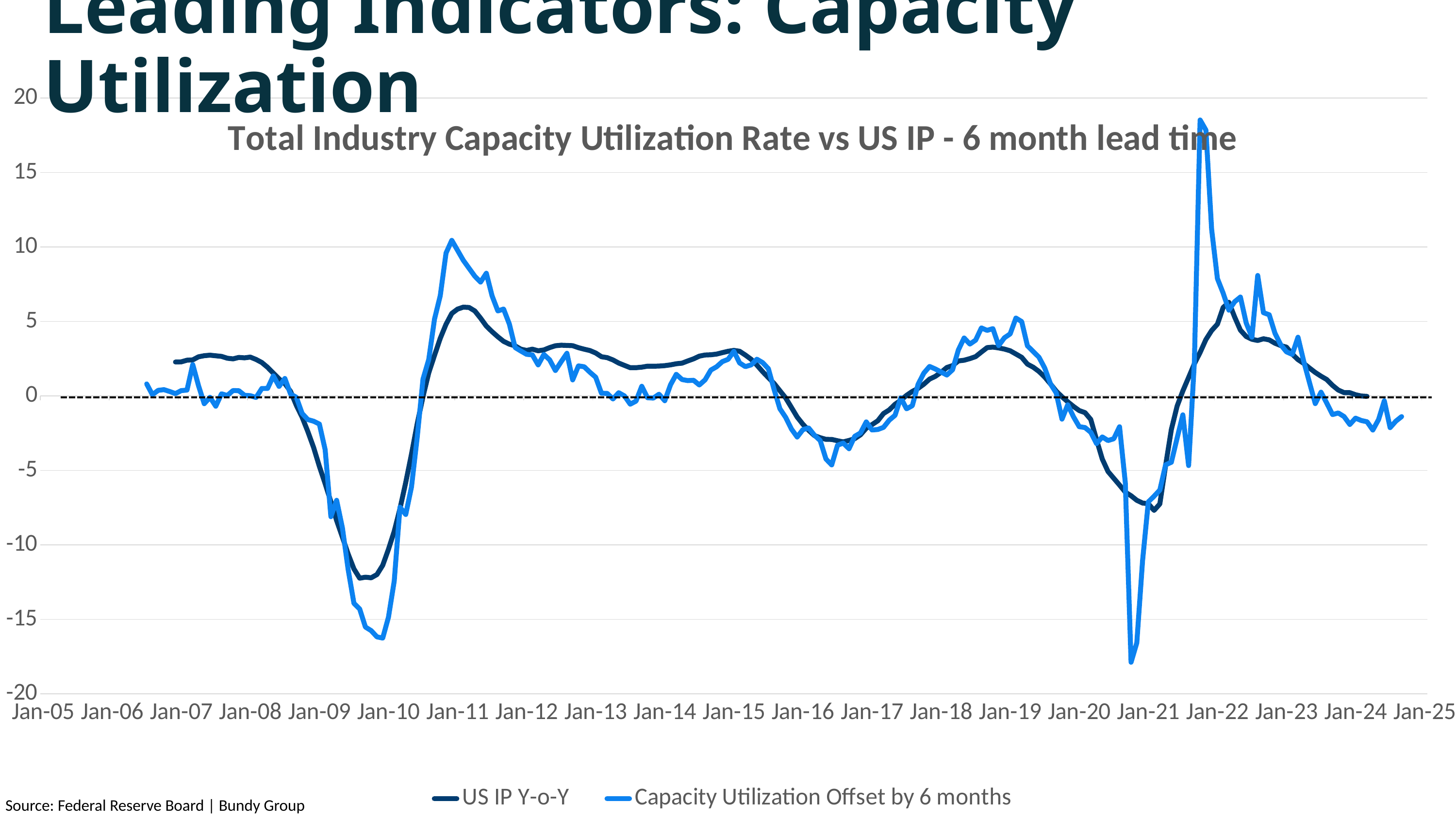
Is the peak value of Capacity Utilization Offset by 6 months around Jan-22 greater or less than 15? greater How many year labels are shown on the x axis? 21 Is the lowest value of US IP Y-o-Y around Jan-10 greater or less than -10? less What kind of chart is shown on the slide? line chart Does the US IP Y-o-Y line rise or fall between Jan-22 and Jan-24? fall Is the peak value of Capacity Utilization Offset by 6 months around Jan-11 greater or less than 5? greater What is the title of the chart? Total Industry Capacity Utilization Rate vs US IP - 6 month lead time How many series does the legend list? 2 Which series is drawn in the lighter blue line? Capacity Utilization Offset by 6 months At the peak around Jan-22, which series reaches the higher value, US IP Y-o-Y or Capacity Utilization Offset by 6 months? Capacity Utilization Offset by 6 months